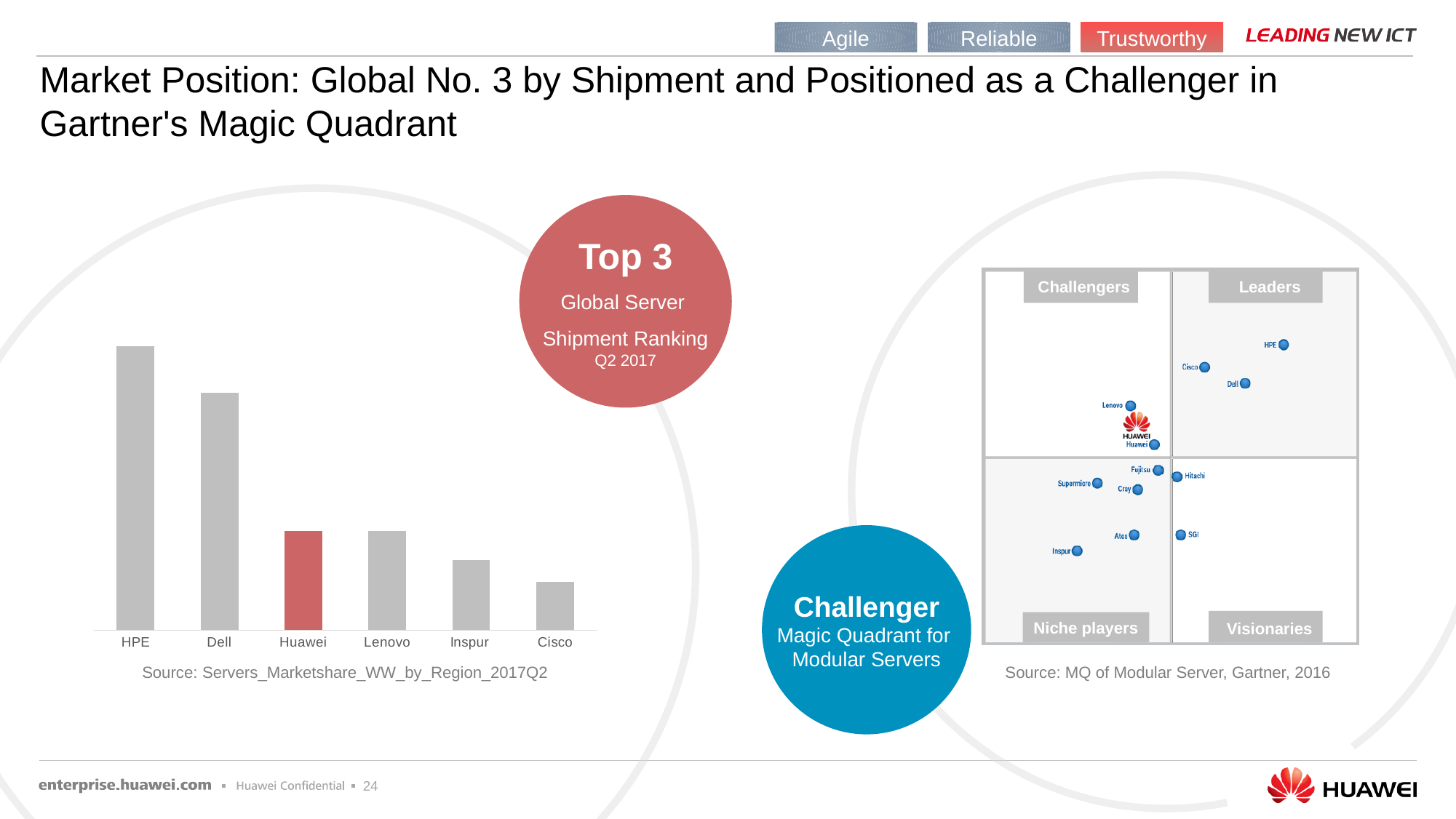
In the bar chart on the left, which is larger, the bar for Lenovo or the bar for Inspur? Lenovo In the bar chart on the left, which is larger, the bar for Inspur or the bar for Cisco? Inspur In the bar chart on the left, which is larger, the bar for Dell or the bar for Huawei? Dell In the Gartner Magic Quadrant on the right, in which quadrant is Huawei positioned? Challengers In the bar chart on the left, which vendor has the highest bar? HPE How many vendors are shown in the bar chart on the left? 6 In the bar chart on the left, do the bars generally rise or fall from HPE on the left to Cisco on the right? Fall What kind of chart is shown on the left of the slide? Bar chart In the bar chart on the left, which vendor's bar is coloured red instead of grey? Huawei In the bar chart on the left, which vendor has the lowest bar? Cisco